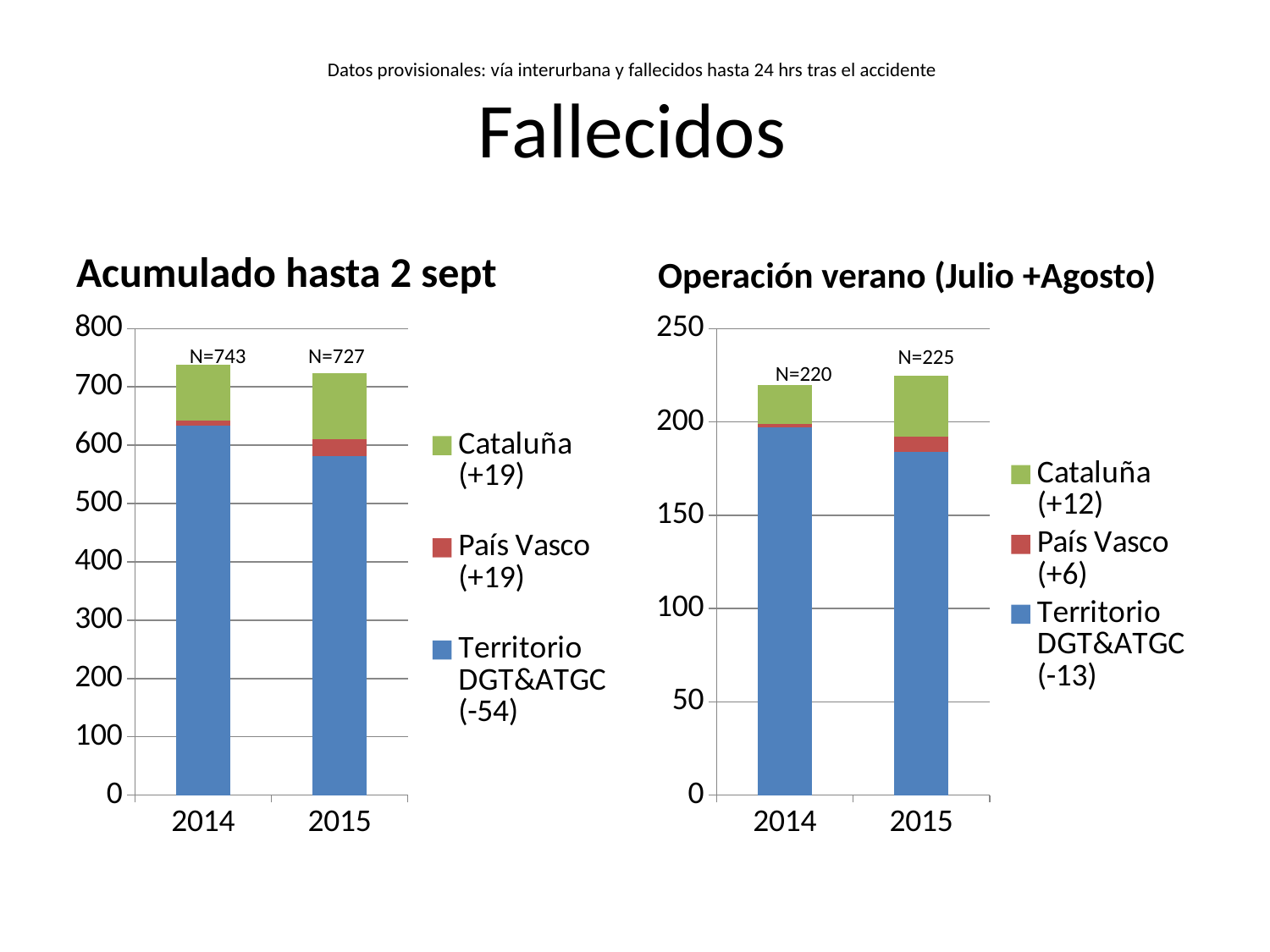
How many series does the legend of the 'Acumulado hasta 2 sept' chart list? 3 In the 'Operación verano (Julio +Agosto)' chart, which year has the higher total, 2014 or 2015? 2015 In the 'Operación verano (Julio +Agosto)' chart, what is the difference between the 2015 total and the 2014 total? 5 In the 'Acumulado hasta 2 sept' chart, what is the total (N) shown above the 2015 bar? N=727 In the 'Acumulado hasta 2 sept' chart, what is the difference between the 2014 total and the 2015 total? 16 In the 'Acumulado hasta 2 sept' chart, is the Territorio DGT&ATGC value for 2015 greater or less than 600? less In the 'Acumulado hasta 2 sept' chart, which year has the higher total, 2014 or 2015? 2014 What kind of chart is the 'Operación verano (Julio +Agosto)' chart? Stacked bar chart In the 'Operación verano (Julio +Agosto)' chart, is the Territorio DGT&ATGC value for 2015 greater or less than 200? less In the 'Operación verano (Julio +Agosto)' chart, what is the total (N) shown above the 2015 bar? N=225 In the 'Acumulado hasta 2 sept' chart, what is the total (N) shown above the 2014 bar? N=743 In the 'Operación verano (Julio +Agosto)' chart, what is the total (N) shown above the 2014 bar? N=220